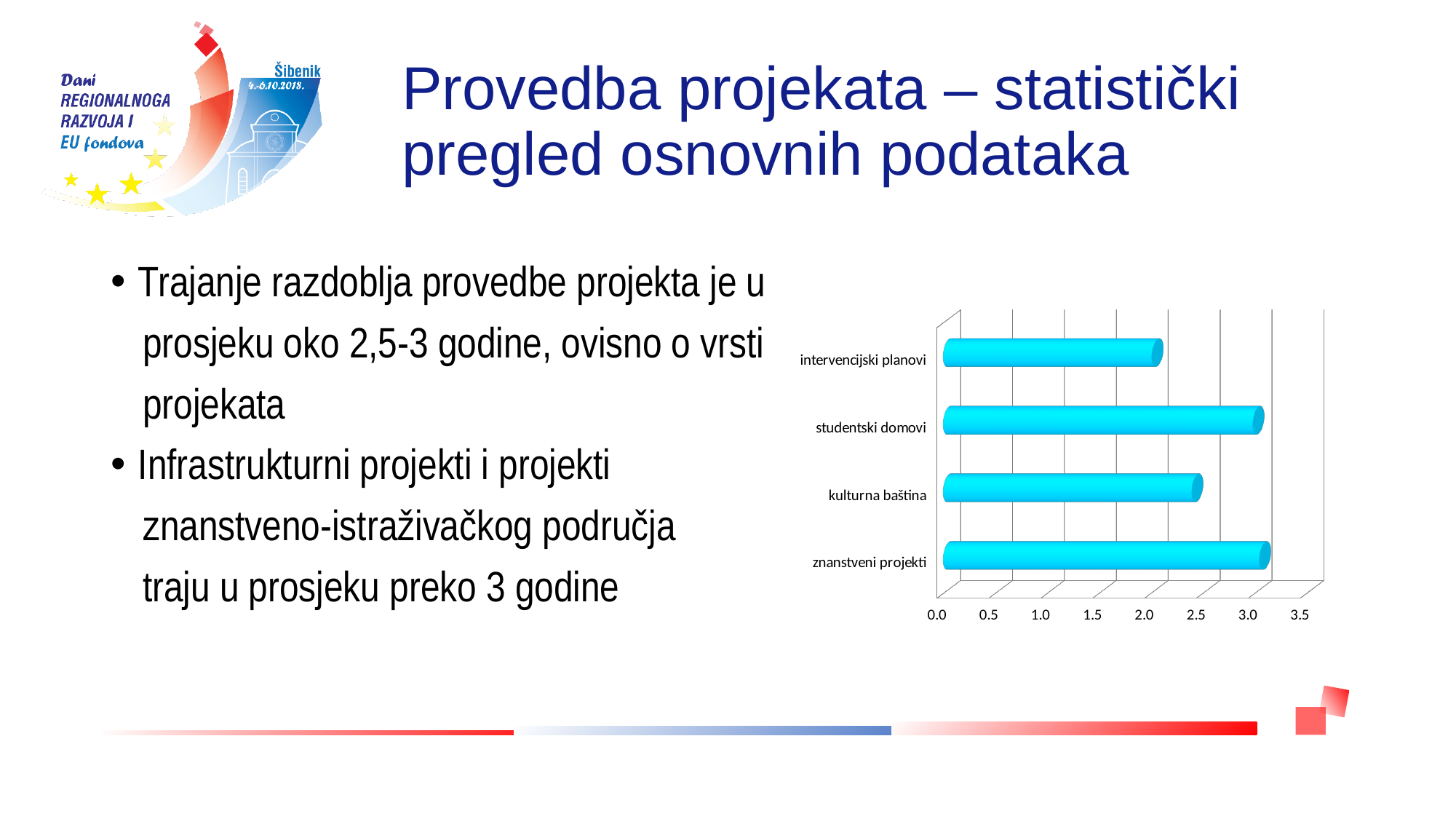
Which category has the lowest value in the chart? intervencijski planovi Is the value for studentski domovi greater or less than 2.5? greater Is the value for kulturna baština greater or less than 3.0? less What is the highest value shown on the chart's horizontal axis? 3.5 Is the value for intervencijski planovi greater or less than 2.5? less Which is larger, the value for studentski domovi or the value for kulturna baština? studentski domovi What kind of chart is shown on the slide? bar chart How many categories are plotted in the chart? 4 Which is larger, the value for kulturna baština or the value for intervencijski planovi? kulturna baština